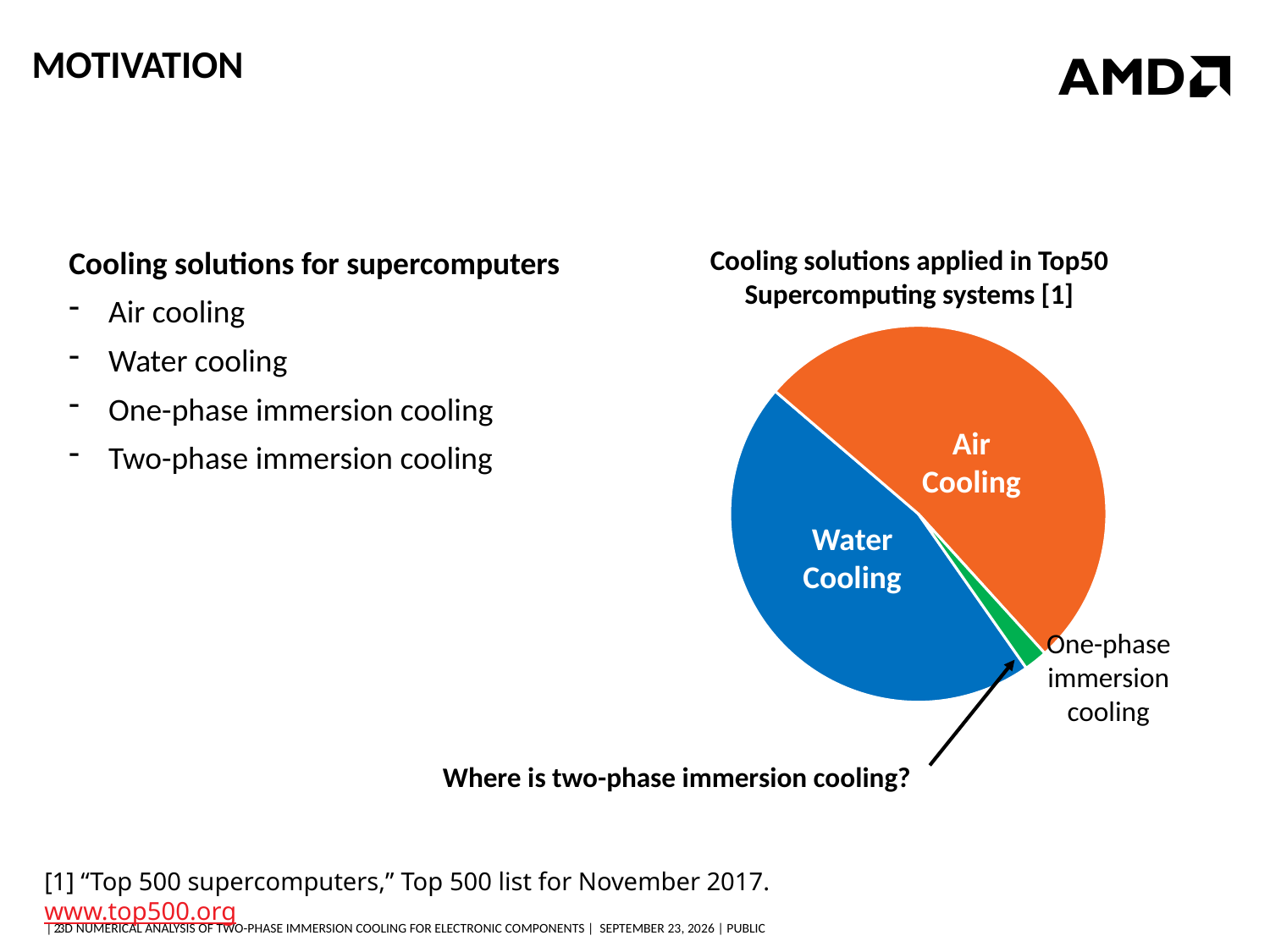
Which slice is larger in the pie chart, Air Cooling or One-phase immersion cooling? Air Cooling Which cooling solution listed on the slide does not appear as a slice in the pie chart? Two-phase immersion cooling Which slice is larger in the pie chart, Water Cooling or One-phase immersion cooling? Water Cooling How many slices does the pie chart have? 3 What colour is the Water Cooling slice in the pie chart? Blue Which cooling solution has the smallest slice in the pie chart? One-phase immersion cooling What is the title of the pie chart? Cooling solutions applied in Top50 Supercomputing systems [1] Which cooling solution has the largest slice in the pie chart? Air Cooling What kind of chart is shown on the slide? Pie chart